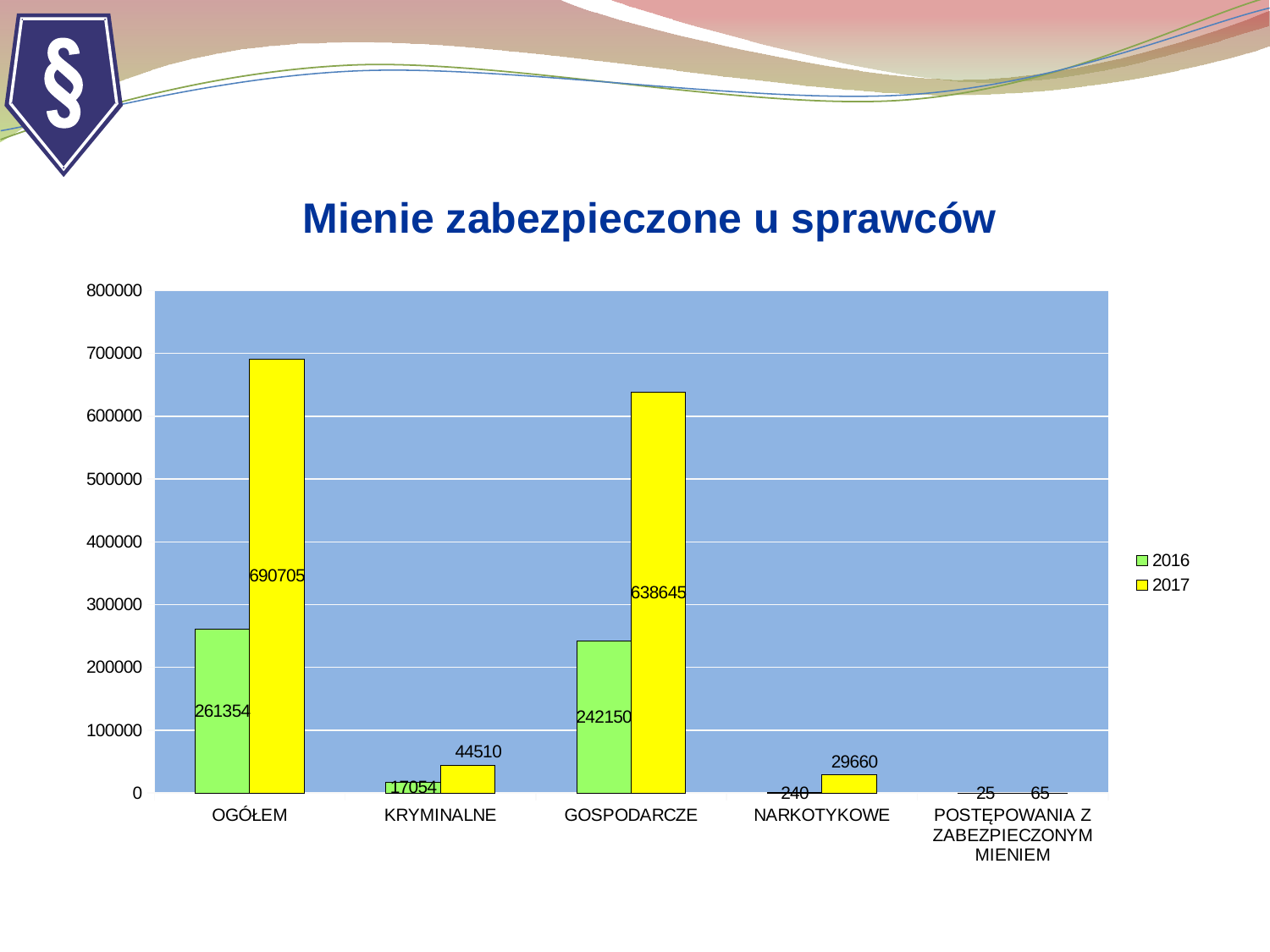
How many categories are shown on the x axis? 5 Which is larger: the 2016 value for OGÓŁEM or the 2016 value for GOSPODARCZE? OGÓŁEM What type of chart is shown on the slide? bar chart What is the 2017 value for KRYMINALNE? 44510 What is the 2017 value for NARKOTYKOWE? 29660 What is the 2016 value for GOSPODARCZE? 242150 Is the 2017 value for GOSPODARCZE greater or less than 600000? greater What is the difference between the 2017 and 2016 values for OGÓŁEM? 429351 What is the 2017 value for OGÓŁEM? 690705 How many series does the legend list? 2 Which category has the lowest 2016 value? POSTĘPOWANIA Z ZABEZPIECZONYM MIENIEM Which category has the highest 2017 value? OGÓŁEM